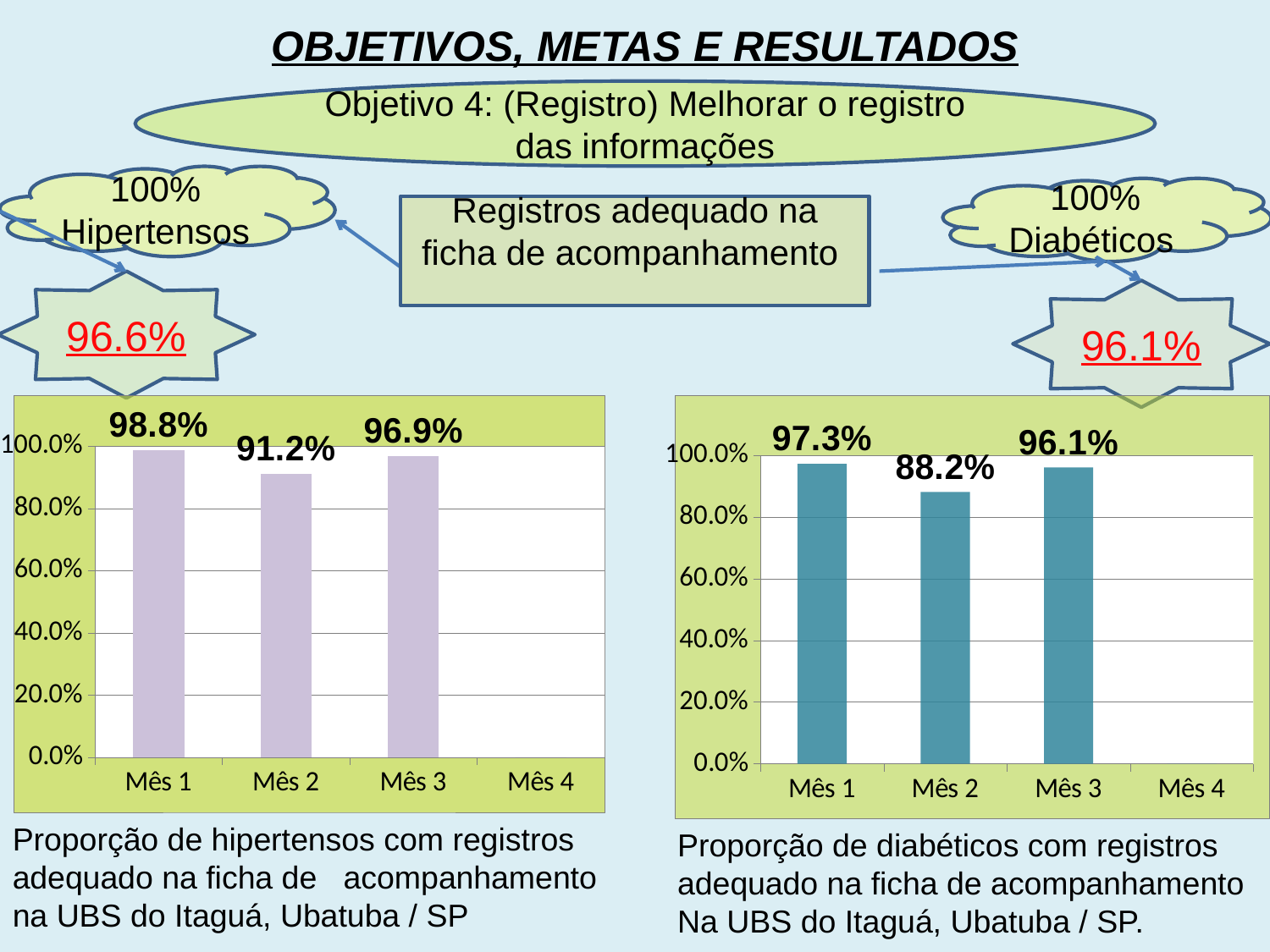
In the left chart (hipertensos), what is the value for Mês 1? 98.8% In the right chart (diabéticos), which is larger, the value for Mês 1 or Mês 3? Mês 1 In the right chart (diabéticos), what is the value for Mês 2? 88.2% How many month categories are shown on the x axis of the left chart (hipertensos)? 4 In the right chart (diabéticos), which month has the lowest value among the plotted bars? Mês 2 In the left chart (hipertensos), what is the value for Mês 2? 91.2% In the left chart (hipertensos), is the value for Mês 2 greater or less than 80.0%? greater In the right chart (diabéticos), what is the value for Mês 3? 96.1% In the left chart (hipertensos), what is the difference between the values for Mês 1 and Mês 2? 7.6% In the left chart (hipertensos), which month has the highest value? Mês 1 What kind of chart is the right chart (diabéticos)? bar chart In the right chart (diabéticos), what is the difference between the values for Mês 1 and Mês 2? 9.1%